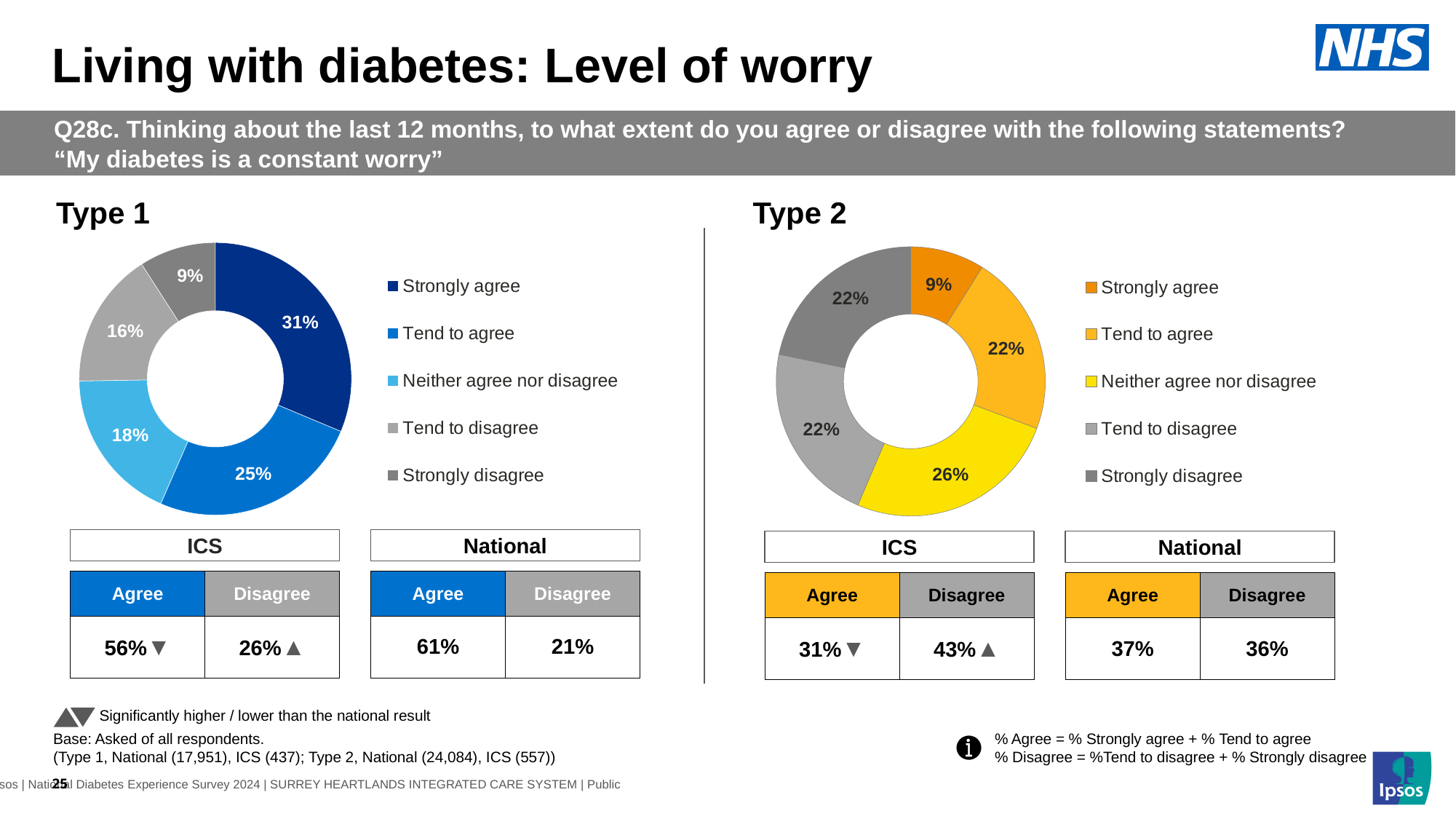
In the Type 2 chart, what colour represents Strongly agree? Orange How many categories does the Type 1 chart show? 5 In the Type 2 chart, which category has the smallest share? Strongly agree What kind of chart is used for Type 2? Donut (pie) chart In the Type 1 chart, what is the difference between the Strongly agree and Tend to agree shares? 6% In the Type 2 chart, which is larger: Strongly agree or Tend to agree? Tend to agree In the Type 1 chart, what percentage of respondents said they strongly agree? 31% In the Type 1 chart, which category has the largest share? Strongly agree In the Type 1 chart, what percentage of respondents said they tend to disagree? 16% In the Type 1 chart, which category has the smallest share? Strongly disagree In the Type 2 chart, which category has the largest share? Neither agree nor disagree In the Type 2 chart, what percentage of respondents said they neither agree nor disagree? 26%